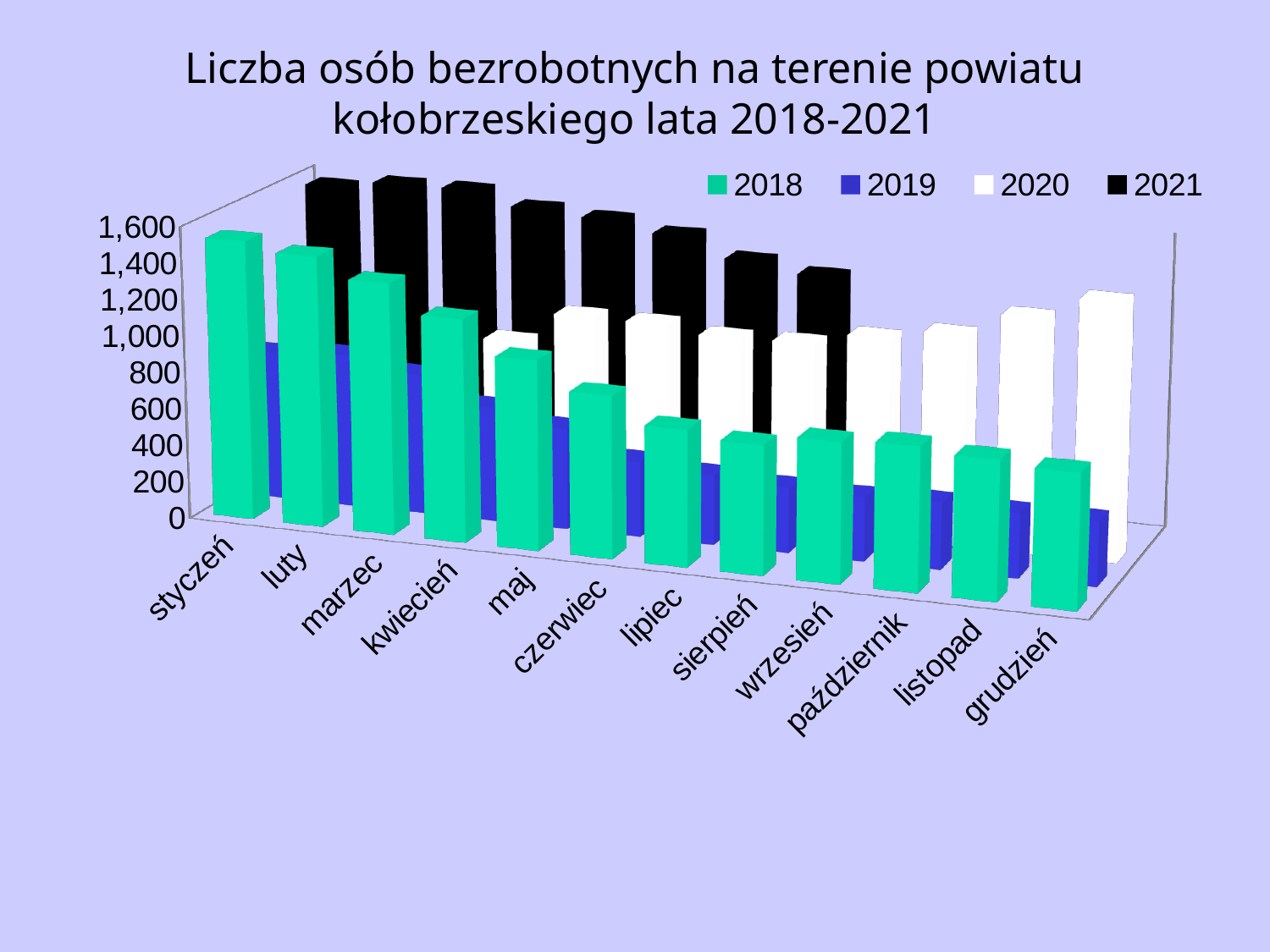
In the 2018 series, which is larger: the value for styczeń or the value for grudzień? styczeń Which years are listed in the legend? 2018, 2019, 2020, 2021 Is the value for luty in the 2018 series greater or less than 800? greater In the 2018 series, which is larger: the value for luty or the value for czerwiec? luty Is the value for styczeń in the 2018 series greater or less than 1,000? greater Do the values for the 2018 series rise or fall from styczeń to grudzień? fall How many series does the legend list? 4 How many months are shown on the x axis? 12 What is the title of the chart? Liczba osób bezrobotnych na terenie powiatu kołobrzeskiego lata 2018-2021 What kind of chart is shown on the slide? bar chart Is the value for grudzień in the 2018 series greater or less than 1,200? less Which month has the highest value for the 2018 series? styczeń